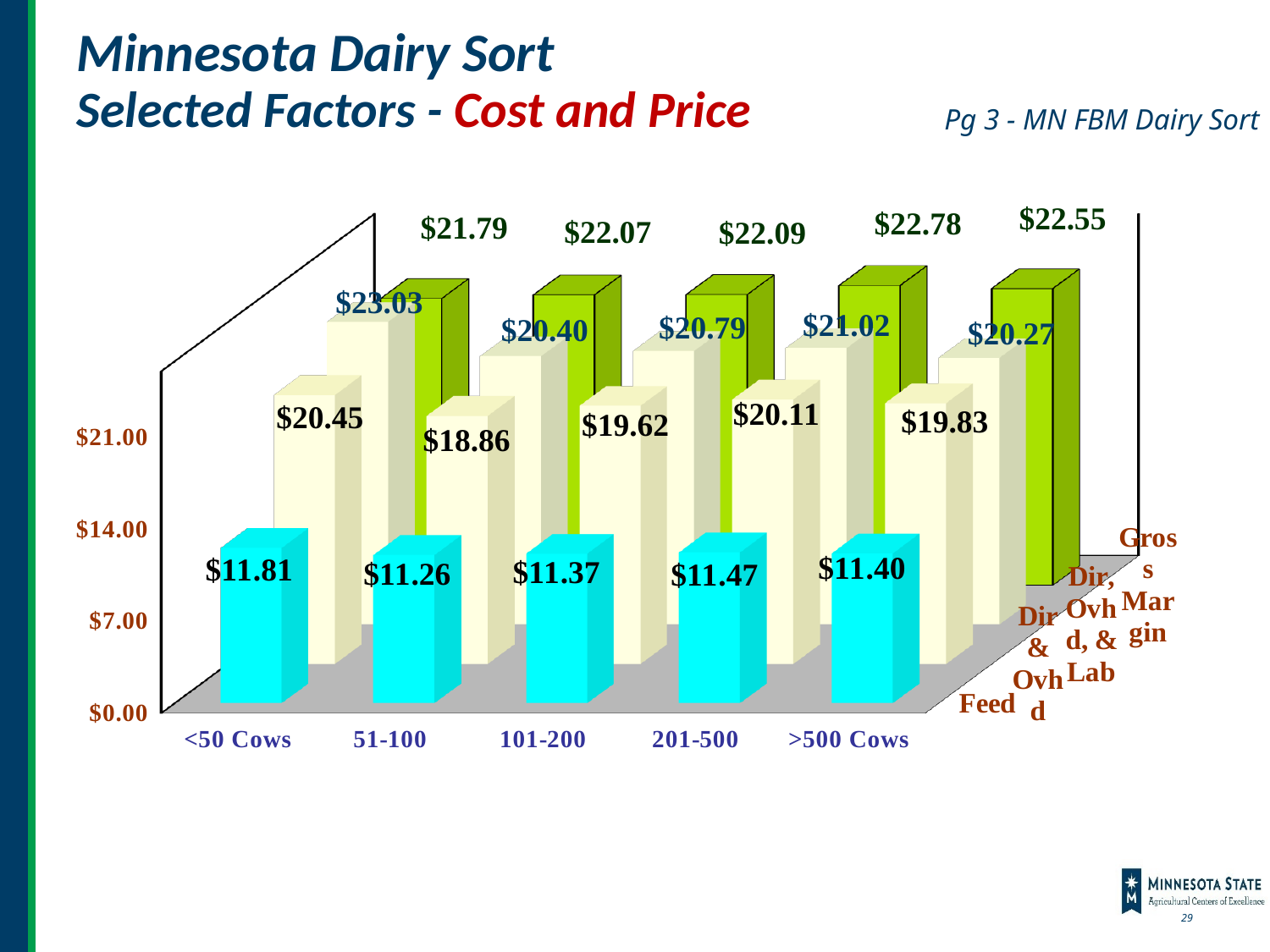
Which herd size category has the highest Gross Margin? 201-500 How many herd size categories are shown on the x axis? 5 What kind of chart is shown on the slide? bar chart Which herd size category has the highest Feed value? <50 Cows Which is larger, the Gross Margin for >500 Cows or for <50 Cows? >500 Cows What is the Dir & Ovhd value for 51-100? $18.86 What is the Dir, Ovhd, & Lab value for <50 Cows? $23.03 What is the Gross Margin value for 201-500? $22.78 Is the Feed value for 201-500 greater or less than $14.00? less What is the Feed value for <50 Cows? $11.81 What is the difference between the Feed value for <50 Cows and for 51-100? $0.55 Which herd size category has the lowest Feed value? 51-100